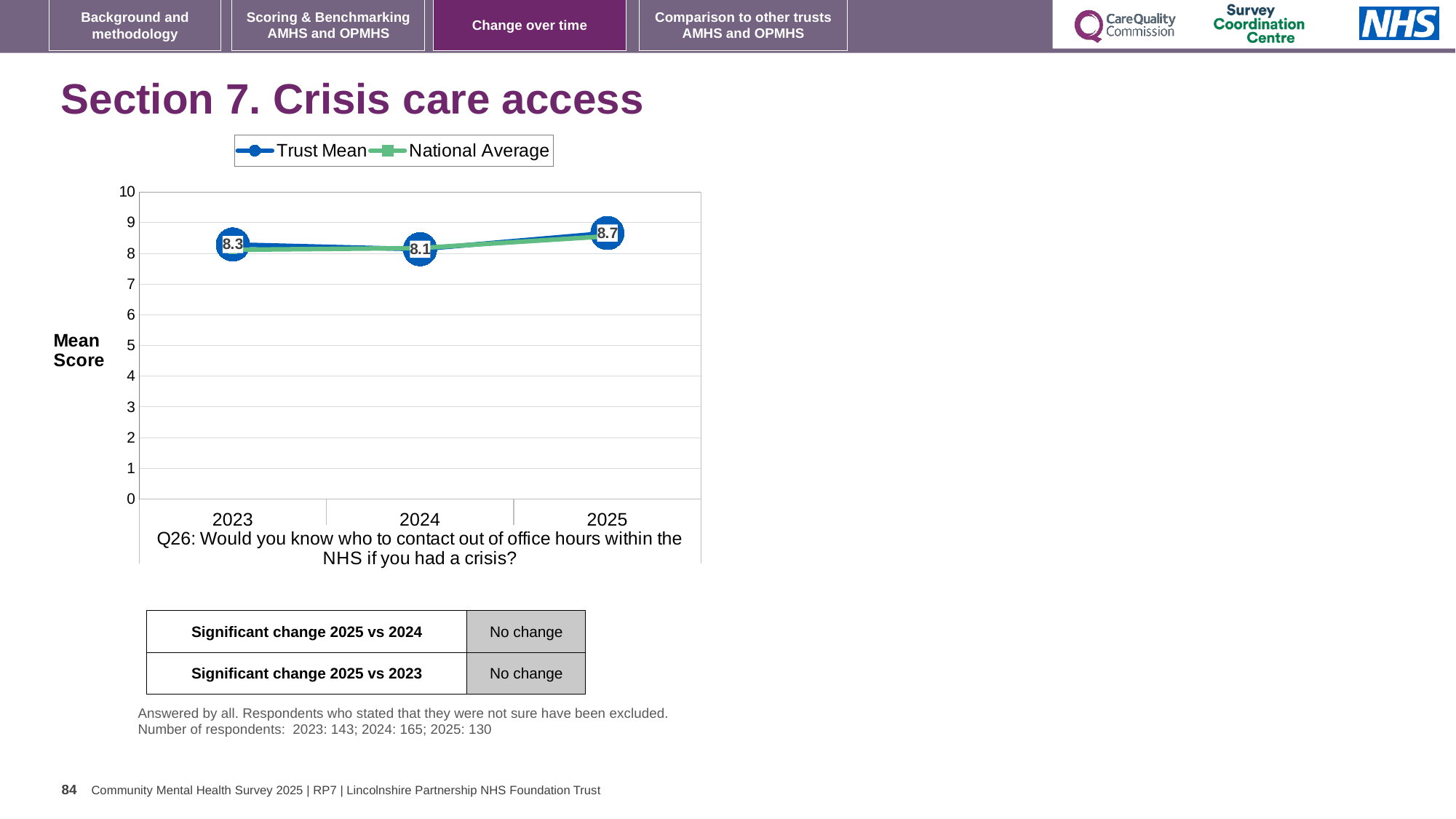
What is the Trust Mean for 2023? 8.3 What is the difference between the Trust Mean in 2025 and in 2024? 0.6 Is the Trust Mean for 2024 greater or less than 9? less In which year is the Trust Mean lowest? 2024 Which is larger, the Trust Mean in 2023 or in 2025? 2025 Does the Trust Mean rise or fall from 2024 to 2025? rise What is the Trust Mean for 2024? 8.1 How many series does the legend list? 2 What is the Trust Mean for 2025? 8.7 How many years are shown on the x axis? 3 What kind of chart is shown? line chart In which year is the Trust Mean highest? 2025